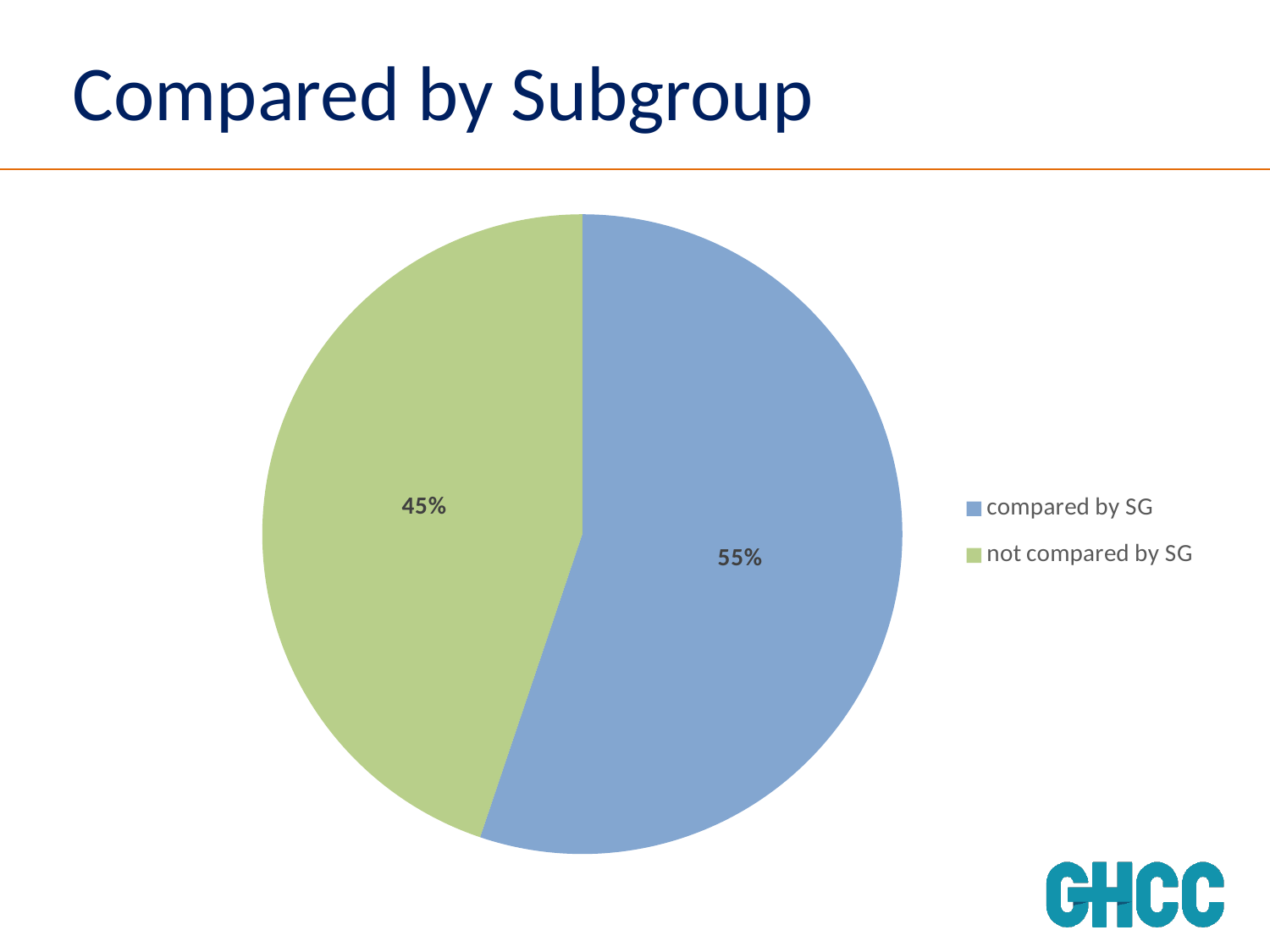
Which slice of the pie is the smallest? not compared by SG What percentage of the pie is labelled "compared by SG"? 55% What share of the pie does the "not compared by SG" slice represent? 45% How many entries does the legend list? 2 What is the difference in percentage points between the "compared by SG" and "not compared by SG" slices? 10 What percentage of the pie is labelled "not compared by SG"? 45% How many slices does the pie chart have? 2 What is the title of the slide containing the pie chart? Compared by Subgroup Which slice of the pie is the largest? compared by SG Which is larger, the "compared by SG" slice or the "not compared by SG" slice? compared by SG What colour is the "compared by SG" slice in the pie chart? blue What kind of chart is shown on the slide? pie chart